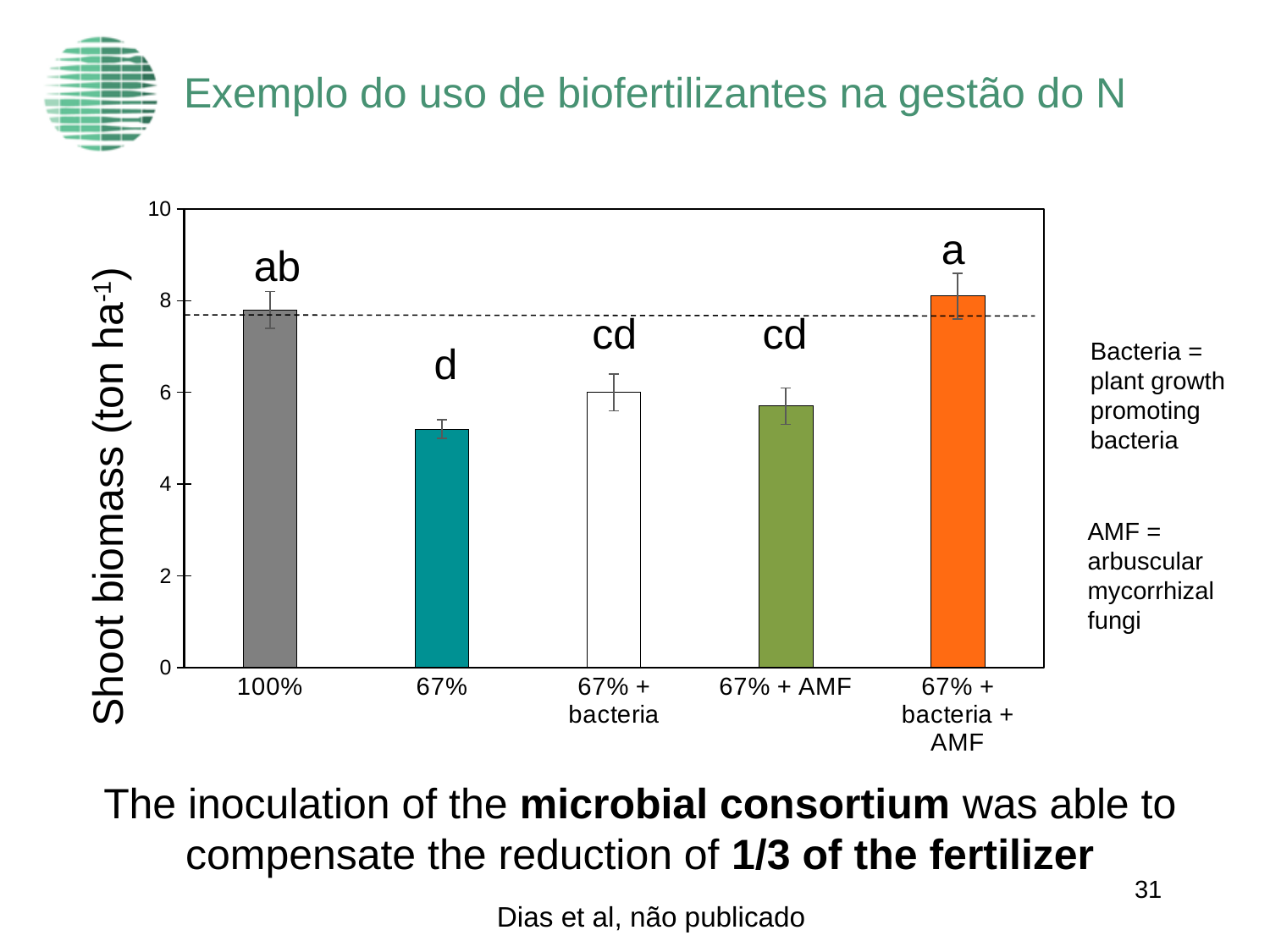
What is the label of the y axis? Shoot biomass (ton ha-1) Which treatment has the lowest shoot biomass? 67% How many bars (treatments) are plotted in the chart? 5 What letter is printed above the 67% + bacteria + AMF bar? a Which has a higher shoot biomass, the 100% treatment or the 67% treatment? 100% What kind of chart is shown on the slide? bar chart Which treatment has the highest shoot biomass? 67% + bacteria + AMF Is the shoot biomass for the 67% + AMF treatment greater or less than 4? greater Is the shoot biomass for the 100% treatment greater or less than 6? greater Which has a higher shoot biomass, 67% + bacteria or 67%? 67% + bacteria Is the shoot biomass for the 67% + bacteria + AMF treatment greater or less than 6? greater